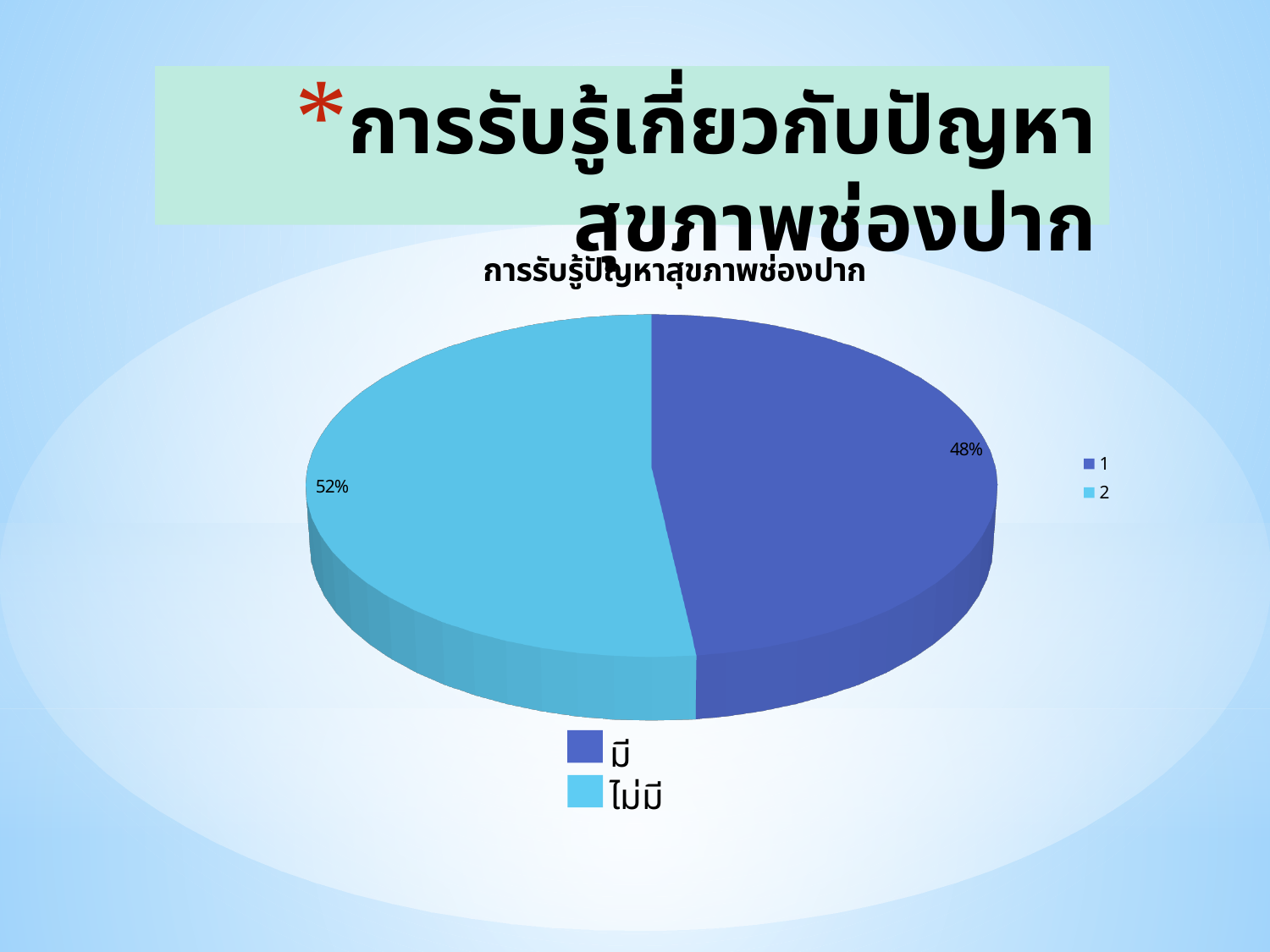
Which is larger, the slice for 1 or the slice for 2? 2 Which slice is the smallest in the pie chart? 1 How many slices does the pie chart have? 2 What percentage is shown for the light blue slice (series 2)? 52% What kind of chart is shown on the slide? pie chart Which slice is the largest in the pie chart? 2 What is the title of the chart? การรับรู้ปัญหาสุขภาพช่องปาก What is the difference in percentage points between slice 2 and slice 1? 4 How many entries does the chart legend list? 2 What share of the pie does the slice labelled 52% represent? 52% Which colour is used for the slice labelled 48%? dark blue What percentage is shown for the dark blue slice (series 1)? 48%